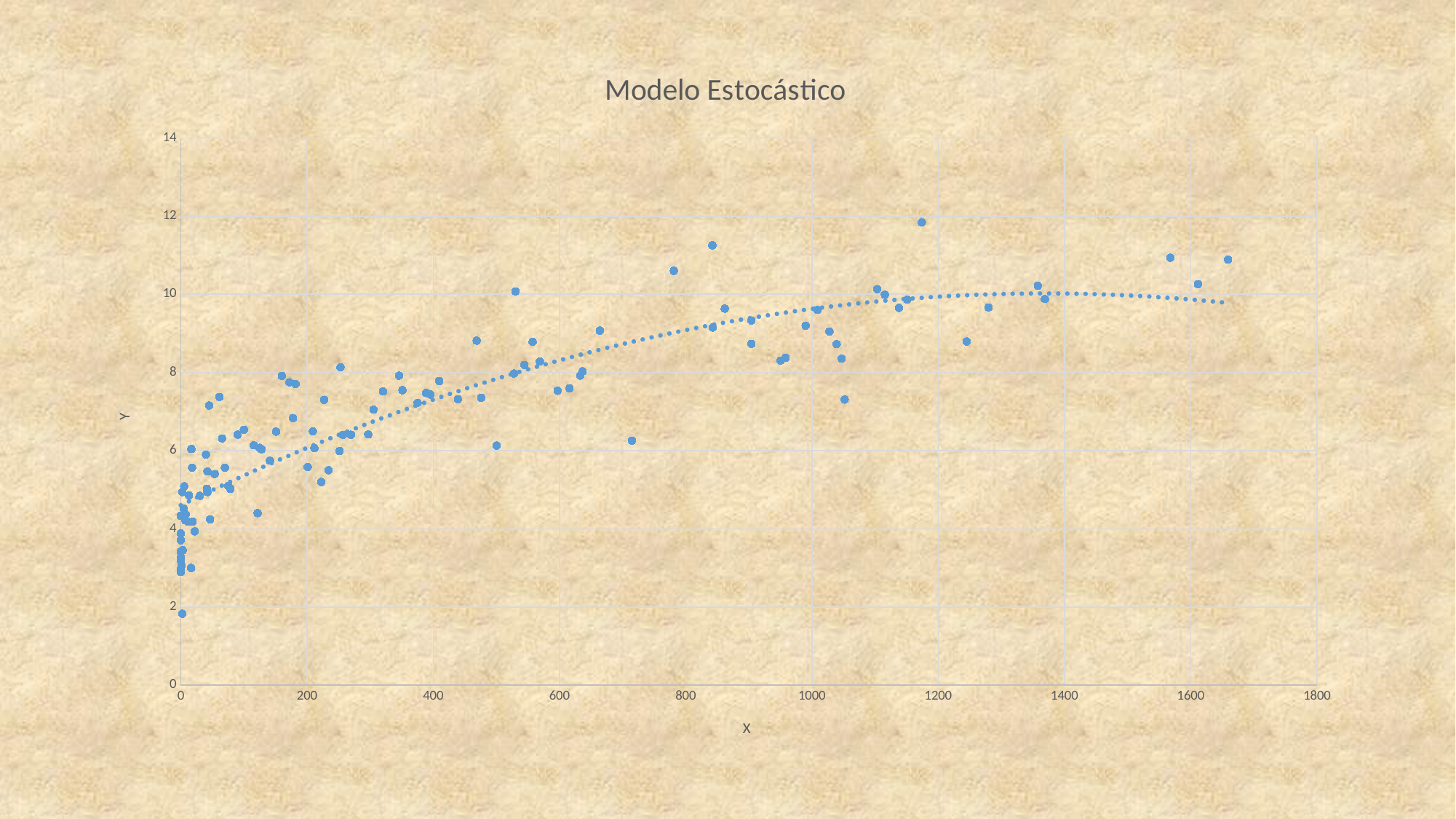
What is the label of the horizontal axis? X Is the highest plotted point, near X = 1200, greater or less than 10 on the Y axis? greater Is the Y value of the point plotted near X = 720 greater or less than 8? less What is the maximum value shown on the Y axis? 14 What is the title of the chart? Modelo Estocástico Do the Y values generally rise or fall as X increases? rise What is the maximum value shown on the X axis? 1800 Is the Y value of the point plotted near X = 1650 greater or less than 10? greater What kind of chart is shown on the slide? scatter chart